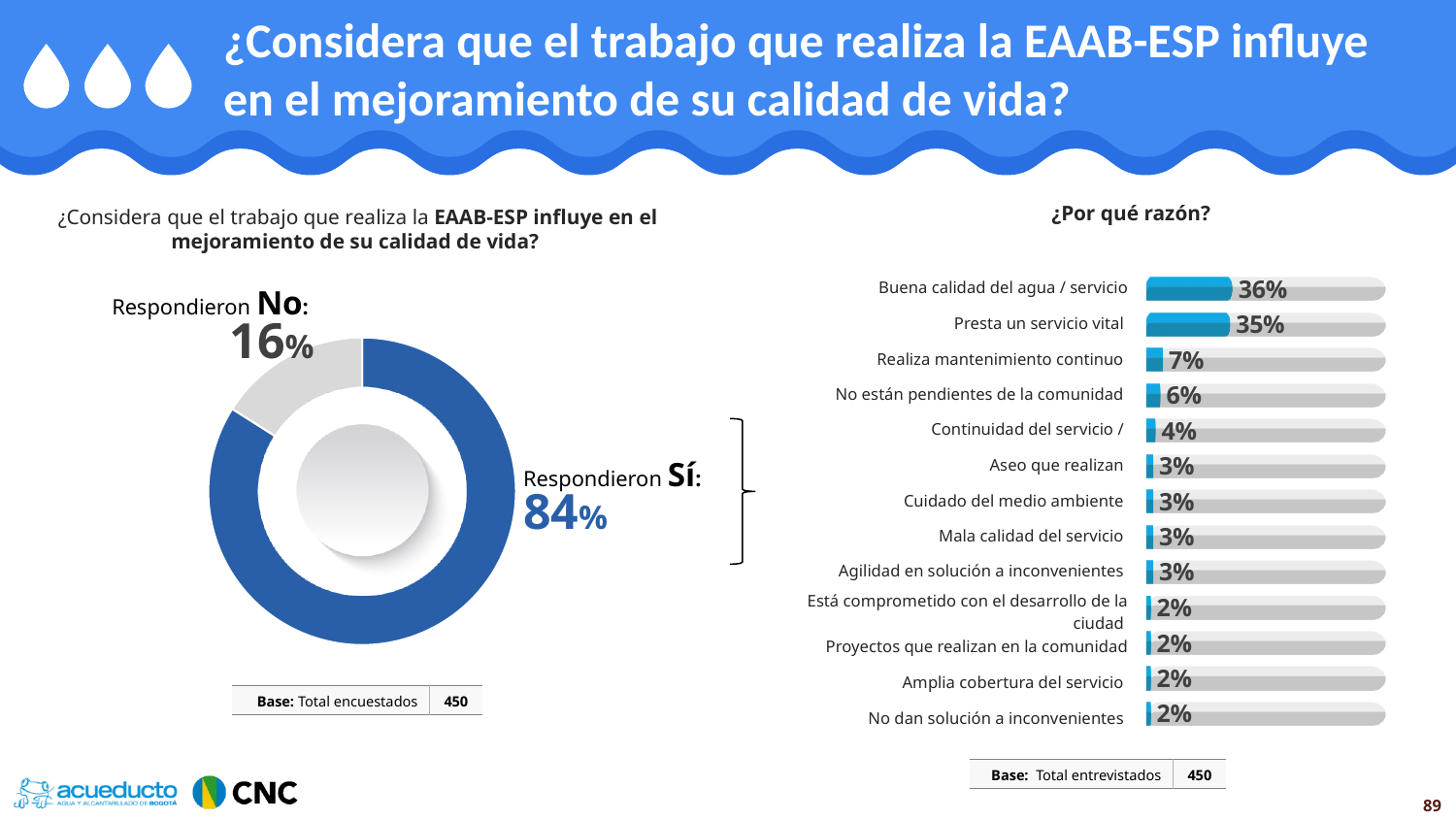
In the '¿Por qué razón?' bar chart, what is the value for 'Realiza mantenimiento continuo'? 7% In the '¿Por qué razón?' bar chart, which is larger, 'Realiza mantenimiento continuo' or 'Continuidad del servicio /'? Realiza mantenimiento continuo In the '¿Por qué razón?' bar chart, what is the value for 'Buena calidad del agua / servicio'? 36% In the donut chart on the left, what percentage of respondents answered No? 16% In the donut chart on the left, which response has the larger share, Sí or No? Sí What is the base (number of respondents) shown below the donut chart on the left? 450 In the '¿Por qué razón?' bar chart, what is the difference between 'Presta un servicio vital' and 'No están pendientes de la comunidad'? 29% How many reasons are listed in the '¿Por qué razón?' bar chart? 13 In the '¿Por qué razón?' bar chart, which reason has the highest value? Buena calidad del agua / servicio In the donut chart on the left, what percentage of respondents answered Sí? 84% In the donut chart on the left, what is the difference between the Sí and No percentages? 68% What kind of chart is the '¿Por qué razón?' chart on the right? Bar chart